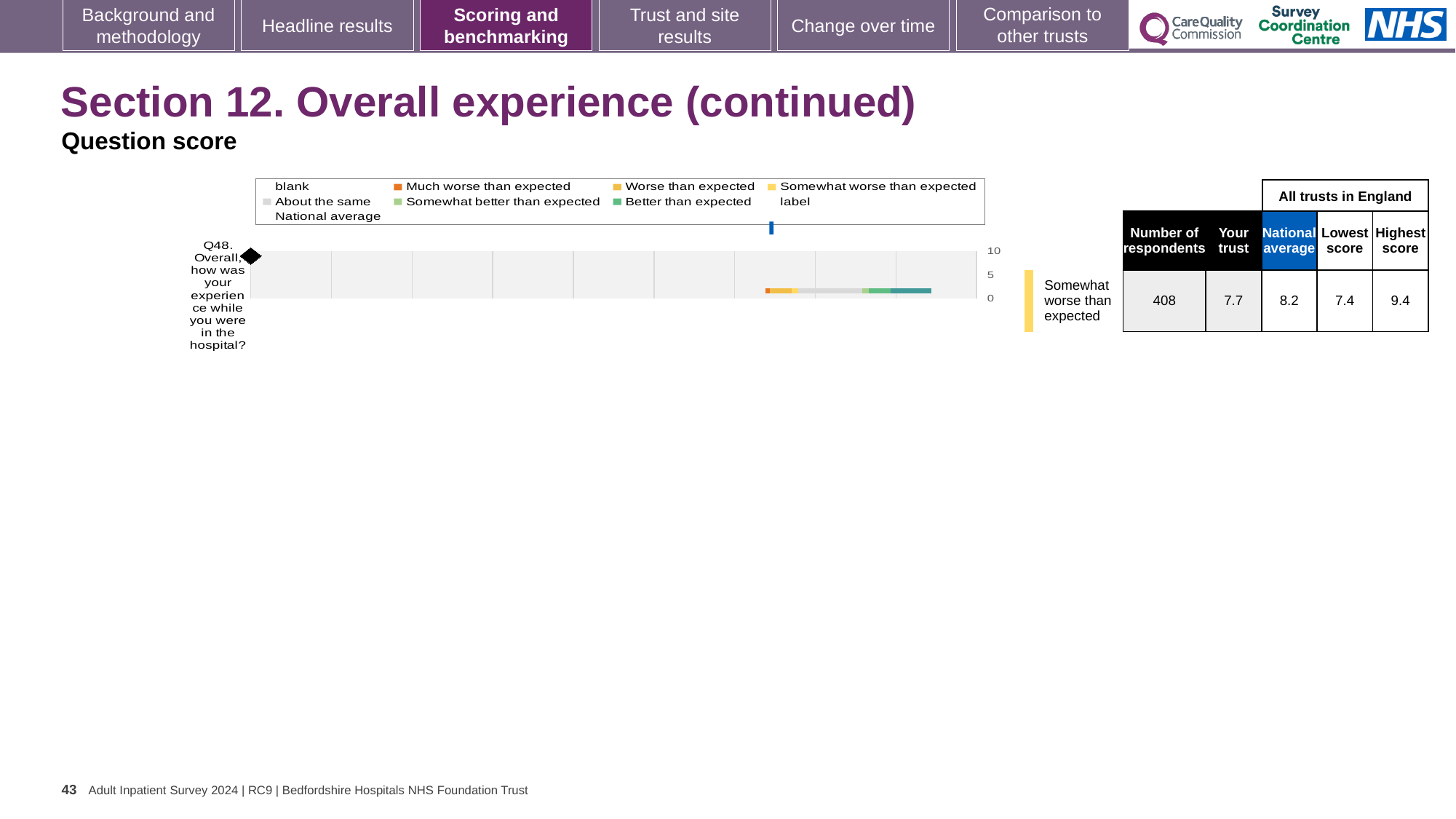
What is the highest value shown on the chart's score axis? 10 Which benchmarking category is the trust's Q48 result labelled as next to the chart? Somewhat worse than expected According to the table beside the chart, what is the national average score for Q48? 8.2 How many questions are plotted in the question score chart? 1 Which question is plotted in the question score chart? Q48. Overall, how was your experience while you were in the hospital? What is the difference between the highest score and the lowest score for Q48 in the table beside the chart? 2.0 According to the table beside the chart, what is the lowest score among all trusts in England for Q48? 7.4 According to the table beside the chart, how many respondents answered Q48? 408 What type of chart is used to show the Q48 question score? bar chart Which is larger for Q48, the trust's score or the national average? National average According to the table beside the chart, what is the trust's score for Q48? 7.7 According to the table beside the chart, what is the highest score among all trusts in England for Q48? 9.4